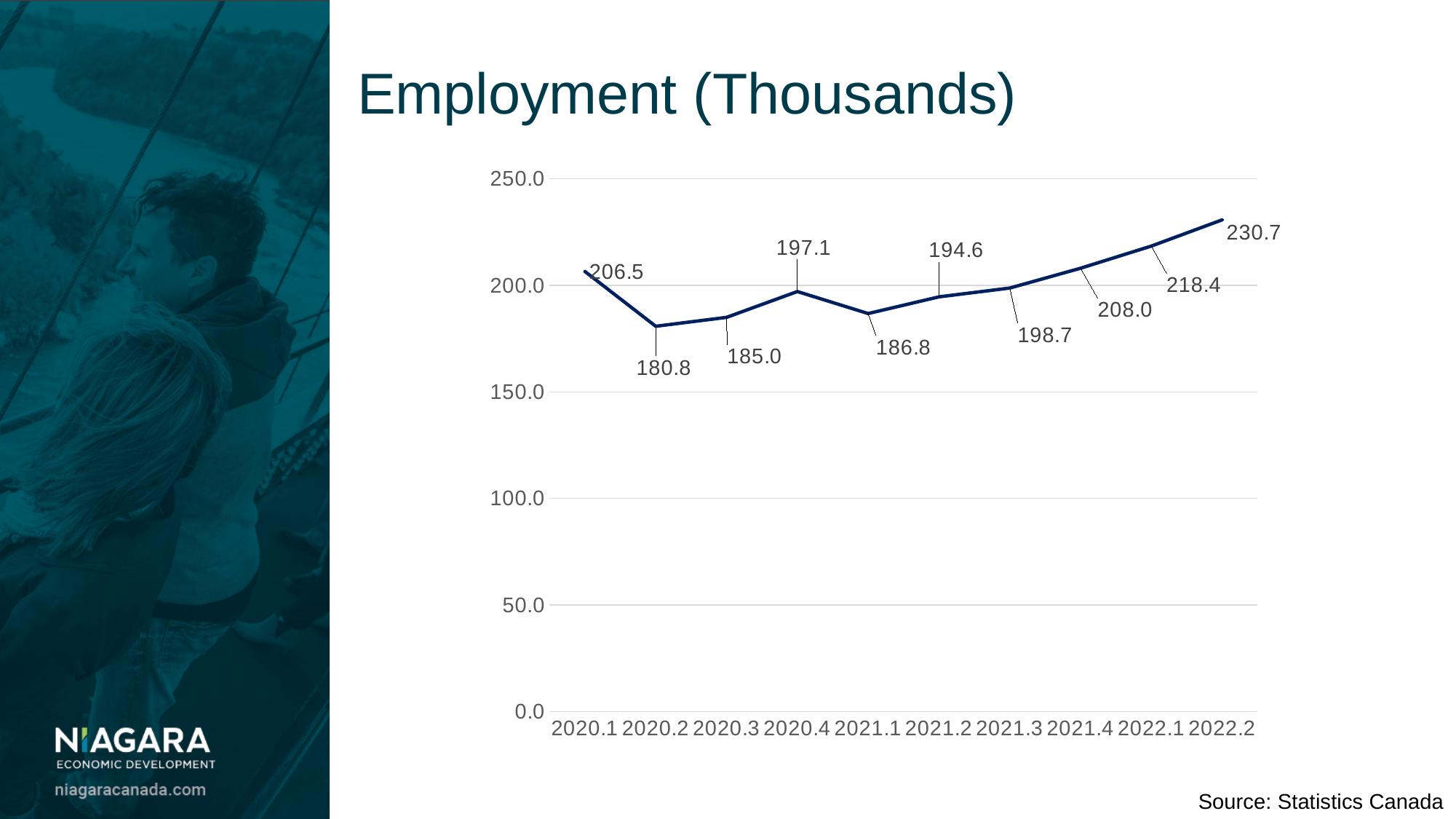
What is the employment value for 2021.3? 198.7 What kind of chart is shown on the slide? line chart Which is larger, the employment value for 2020.4 or for 2021.2? 2020.4 Which period has the lowest employment value? 2020.2 How many periods are plotted on the x axis? 10 What is the difference between the employment values for 2022.2 and 2020.2? 49.9 What is the employment value for 2022.2? 230.7 What is the title of the chart? Employment (Thousands) What is the employment value for 2020.1? 206.5 Do the employment values rise or fall from 2021.1 to 2022.2? rise Is the employment value for 2021.1 greater or less than 200.0? less Which period has the highest employment value? 2022.2